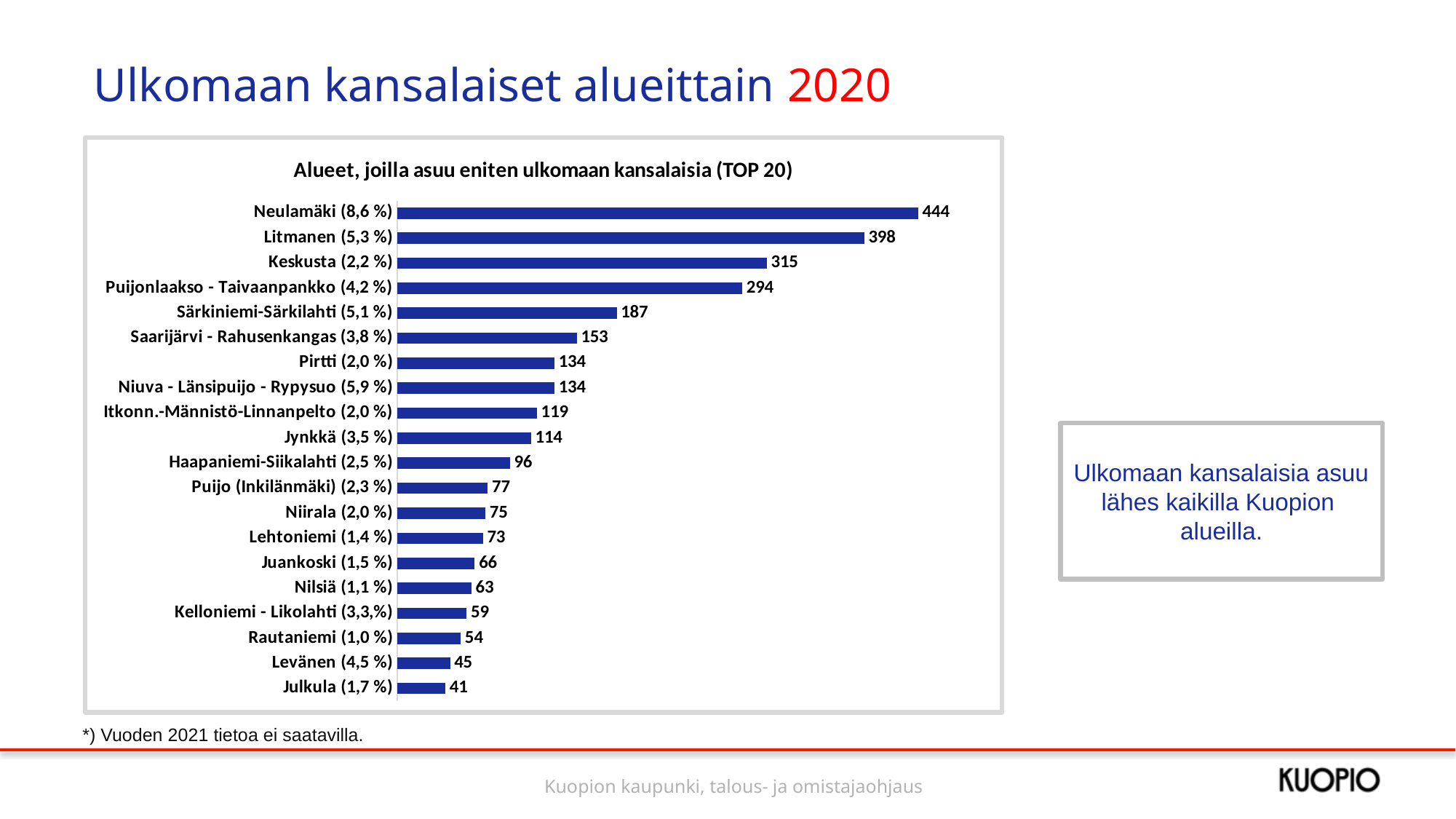
What is the value for Julkula (1,7 %)? 41 What is the title of the chart? Alueet, joilla asuu eniten ulkomaan kansalaisia (TOP 20) What is the value for Neulamäki (8,6 %)? 444 What is the value for Saarijärvi - Rahusenkangas (3,8 %)? 153 Which has a larger value, Särkiniemi-Särkilahti (5,1 %) or Jynkkä (3,5 %)? Särkiniemi-Särkilahti (5,1 %) What kind of chart is shown on the slide? Bar chart How many areas are shown in the chart? 20 What is the difference between the values for Neulamäki (8,6 %) and Litmanen (5,3 %)? 46 Which area has the lowest value? Julkula (1,7 %) Which area has the highest value? Neulamäki (8,6 %) What is the difference between the values for Keskusta (2,2 %) and Puijonlaakso - Taivaanpankko (4,2 %)? 21 What is the value for Niuva - Länsipuijo - Rypysuo (5,9 %)? 134